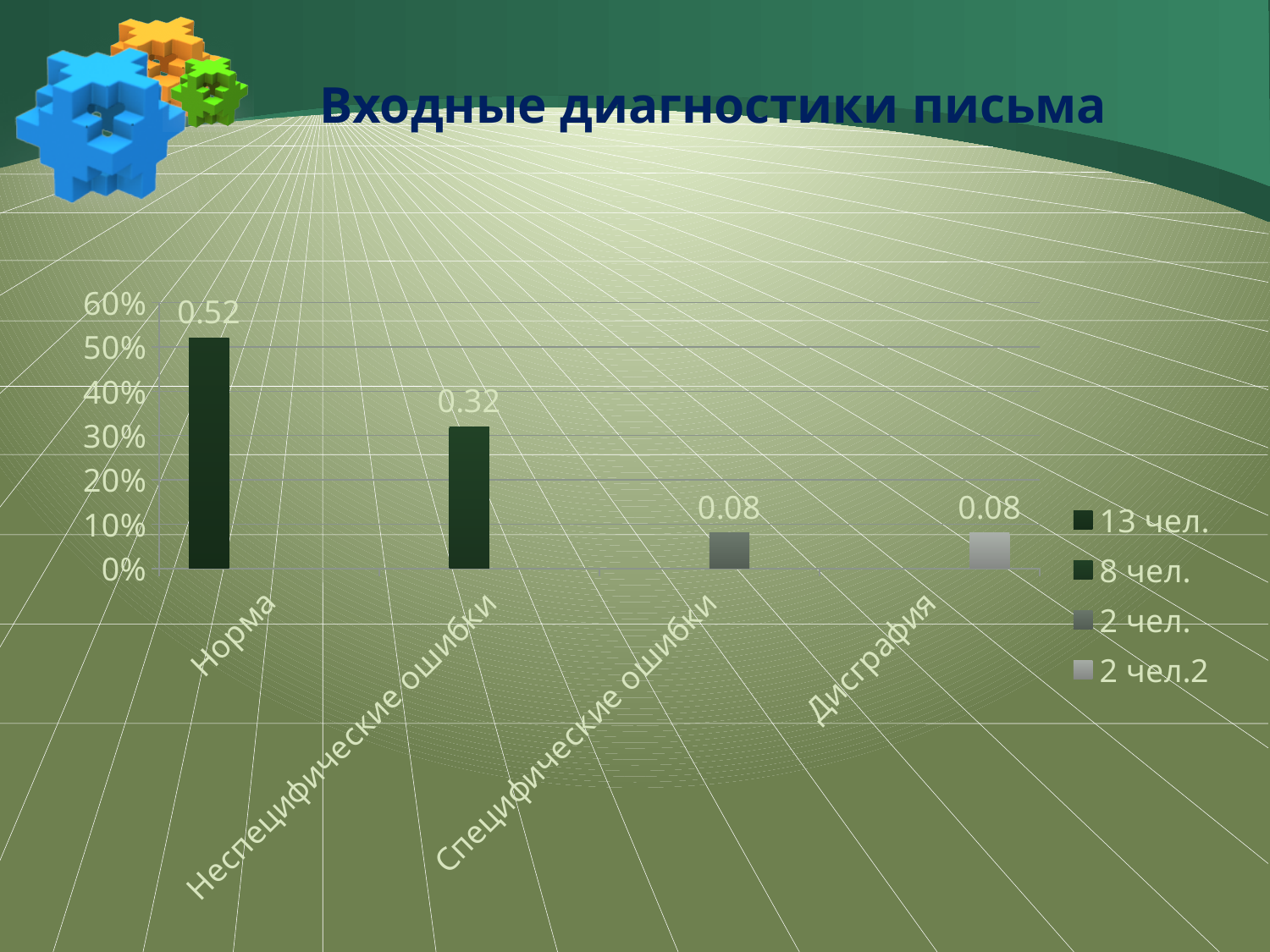
Is the value for Норма greater or less than 40%? greater Do the values rise or fall from Норма to Специфические ошибки along the x axis? fall What is the value shown for Норма? 0.52 What is the value shown for Дисграфия? 0.08 How many categories are shown on the x axis? 4 Which is larger, the value for Неспецифические ошибки or the value for Специфические ошибки? Неспецифические ошибки How many entries does the legend list? 4 What is the title of the slide? Входные диагностики письма What is the difference between the values for Норма and Неспецифические ошибки? 0.2 What is the value shown for Неспецифические ошибки? 0.32 Which category has the highest value? Норма What kind of chart is shown on the slide? bar chart